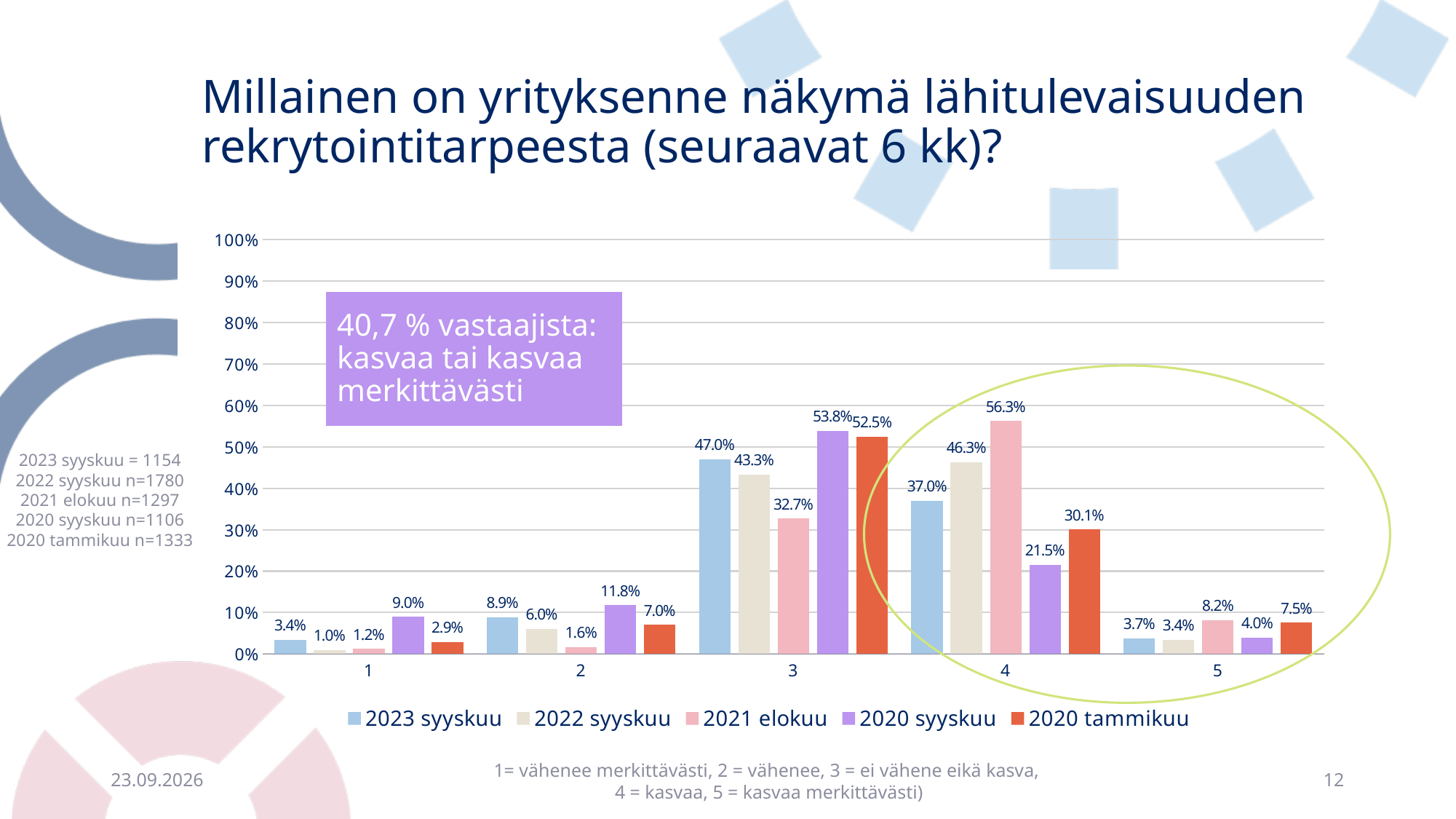
What is the value for 2023 syyskuu in category 3? 47.0% What is the difference between the 2022 syyskuu and 2023 syyskuu values in category 4? 9.3% What colour represents the 2020 tammikuu series? Orange-red What is the value for 2020 syyskuu in category 1? 9.0% How many categories are shown on the x axis? 5 What kind of chart is shown on the slide? Bar chart What is the value for 2021 elokuu in category 4? 56.3% Which is larger in category 5: the value for 2021 elokuu or the value for 2020 syyskuu? 2021 elokuu Which series has the lowest value in category 2? 2021 elokuu Which series has the highest value in category 3? 2020 syyskuu How many series does the legend list? 5 What is the value for 2020 tammikuu in category 5? 7.5%